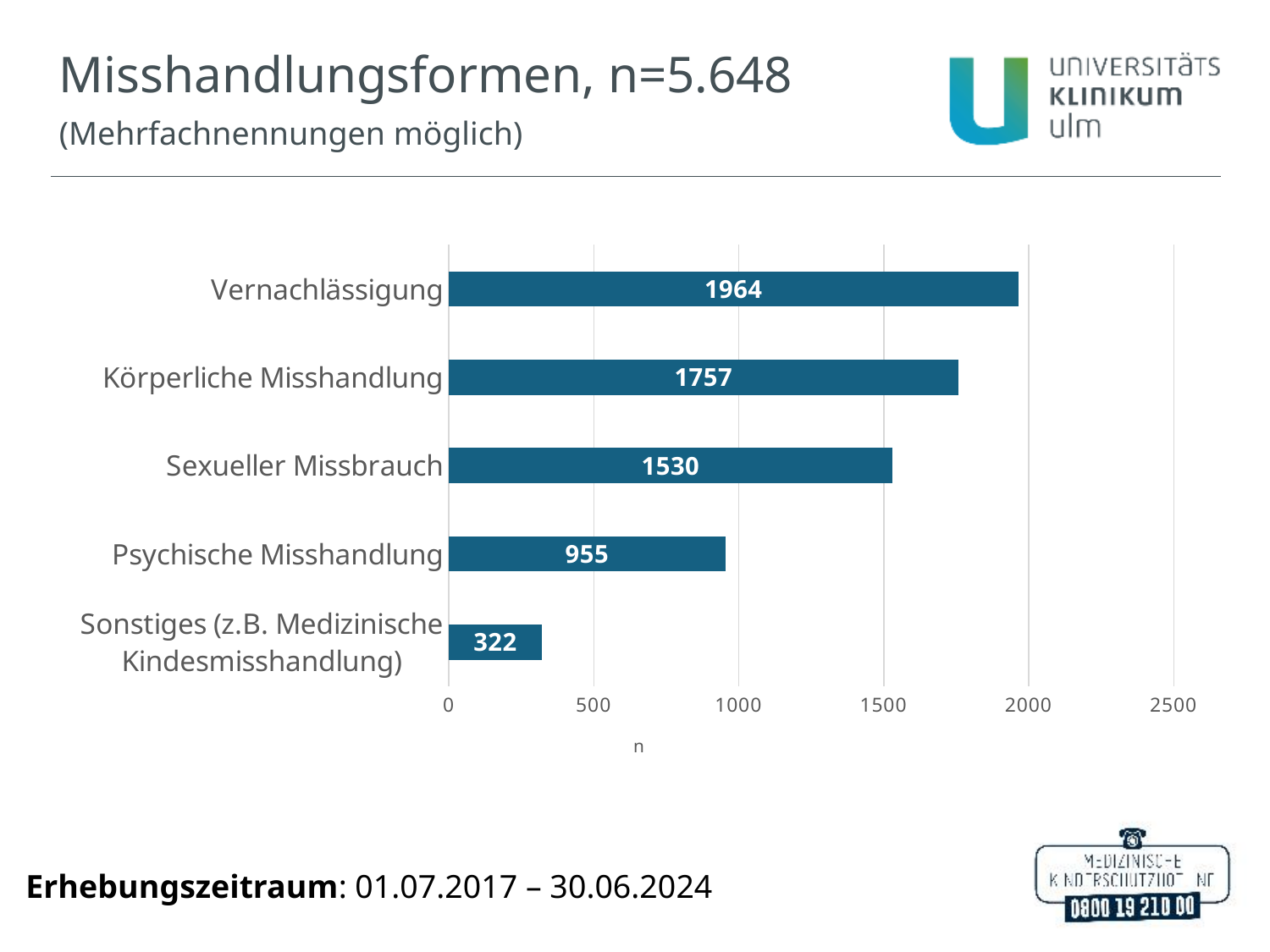
Which category has the highest value? Vernachlässigung Which category has the lowest value? Sonstiges (z.B. Medizinische Kindesmisshandlung) What is the difference between the values for Vernachlässigung and Körperliche Misshandlung? 207 What is the value for Körperliche Misshandlung? 1757 What kind of chart is shown on the slide? Bar chart What is the value for Sonstiges (z.B. Medizinische Kindesmisshandlung)? 322 Which is larger, the value for Sexueller Missbrauch or the value for Psychische Misshandlung? Sexueller Missbrauch What is the title of the chart on the slide? Misshandlungsformen, n=5.648 How many categories are shown in the chart? 5 What is the value for Vernachlässigung? 1964 What is the value for Psychische Misshandlung? 955 What is the value for Sexueller Missbrauch? 1530